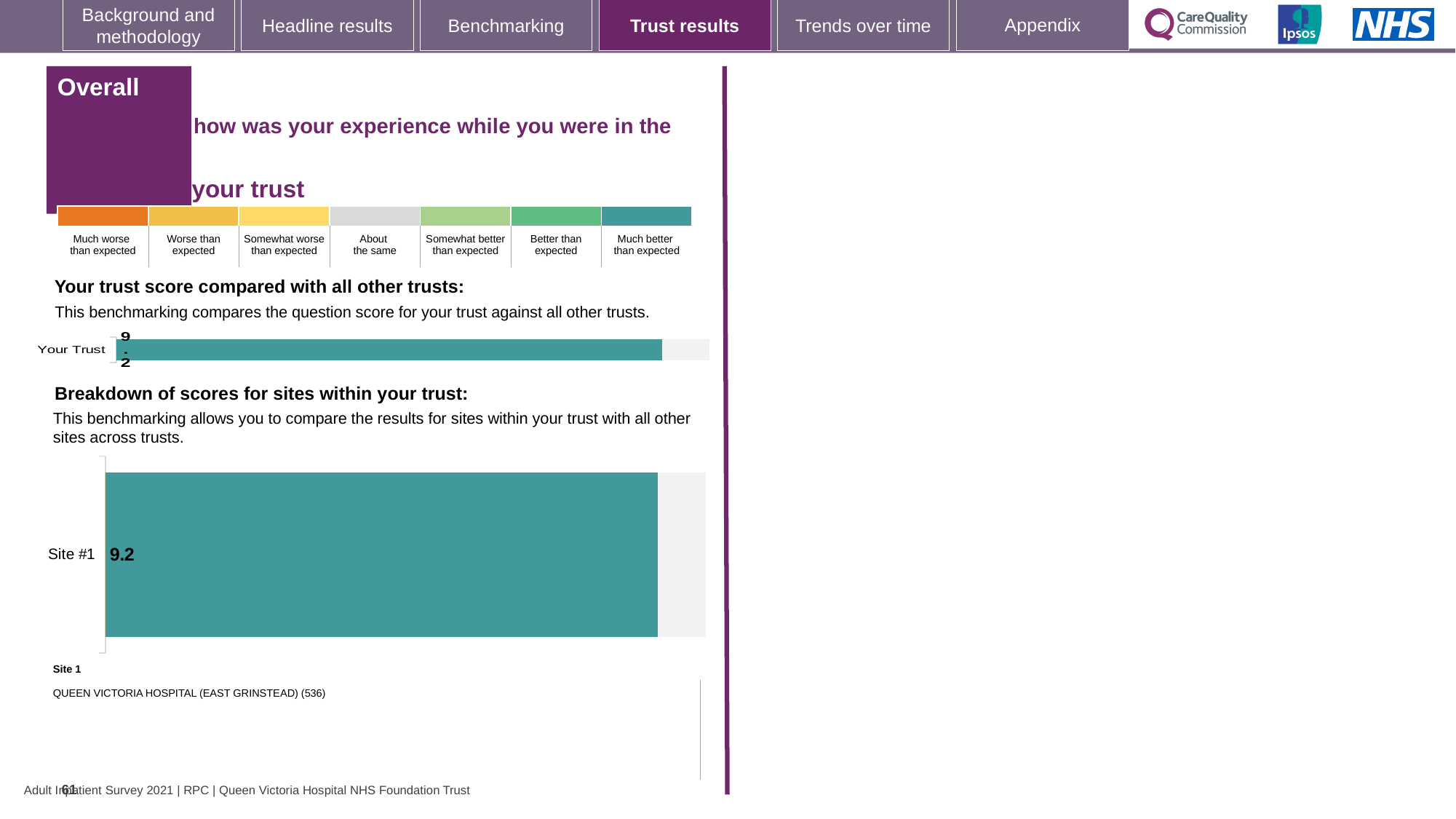
In the 'Your trust score compared with all other trusts' chart, what is the value for Your Trust? 9.2 How many bars are plotted in the 'Breakdown of scores for sites within your trust' chart? 1 In the 'Breakdown of scores for sites within your trust' chart, what is the value for Site #1? 9.2 How many bars are plotted in the 'Your trust score compared with all other trusts' chart? 1 Which hospital is listed as Site 1 below the 'Breakdown of scores for sites within your trust' chart? QUEEN VICTORIA HOSPITAL (EAST GRINSTEAD) (536) What kind of chart is the 'Your trust score compared with all other trusts' chart? bar chart What kind of chart is the 'Breakdown of scores for sites within your trust' chart? bar chart What is the label of the category plotted in the 'Breakdown of scores for sites within your trust' chart? Site #1 Is the value for Your Trust in the 'Your trust score compared with all other trusts' chart the same as the value for Site #1 in the 'Breakdown of scores for sites within your trust' chart? Yes What is the difference between the Your Trust score and the Site #1 score shown on the slide? 0